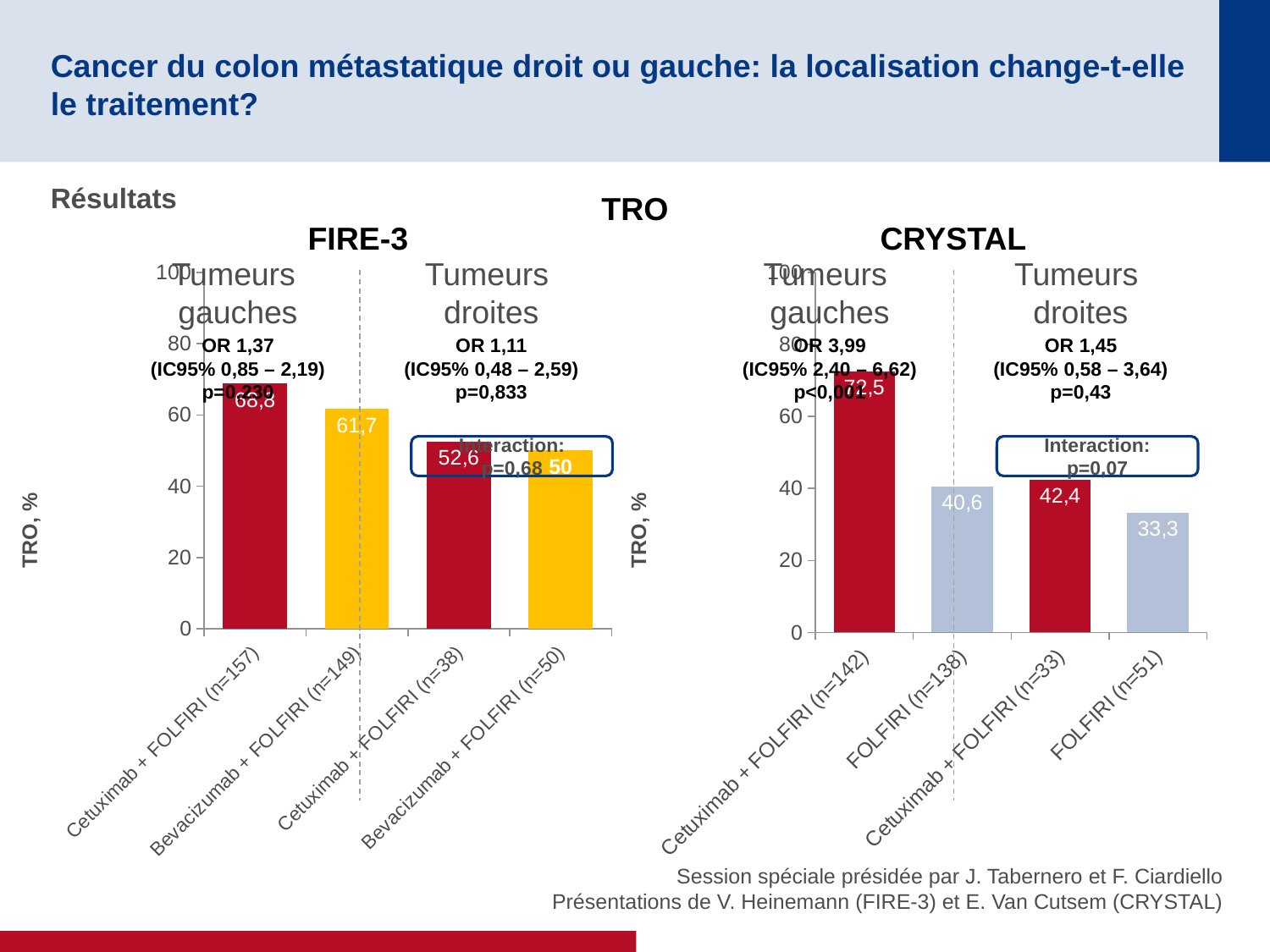
In the CRYSTAL chart, which category has the highest value? Cetuximab + FOLFIRI (n=142) In the CRYSTAL chart, how many bars are plotted? 4 In the CRYSTAL chart, what is the value for FOLFIRI (n=51)? 33,3 In the FIRE-3 chart, what is the value for Bevacizumab + FOLFIRI (n=149)? 61,7 In the CRYSTAL chart, what is the value for Cetuximab + FOLFIRI (n=33)? 42,4 In the FIRE-3 chart, what is the value for Bevacizumab + FOLFIRI (n=50)? 50 In the FIRE-3 chart, which category has the lowest value? Bevacizumab + FOLFIRI (n=50) In the CRYSTAL chart, what is the value for FOLFIRI (n=138)? 40,6 What kind of chart is the FIRE-3 chart? bar chart In the FIRE-3 chart, what is the difference between Bevacizumab + FOLFIRI (n=149) and Cetuximab + FOLFIRI (n=38)? 9,1 In the FIRE-3 chart, is the value for Cetuximab + FOLFIRI (n=157) greater or less than 60? greater In the FIRE-3 chart, what is the value for Cetuximab + FOLFIRI (n=38)? 52,6